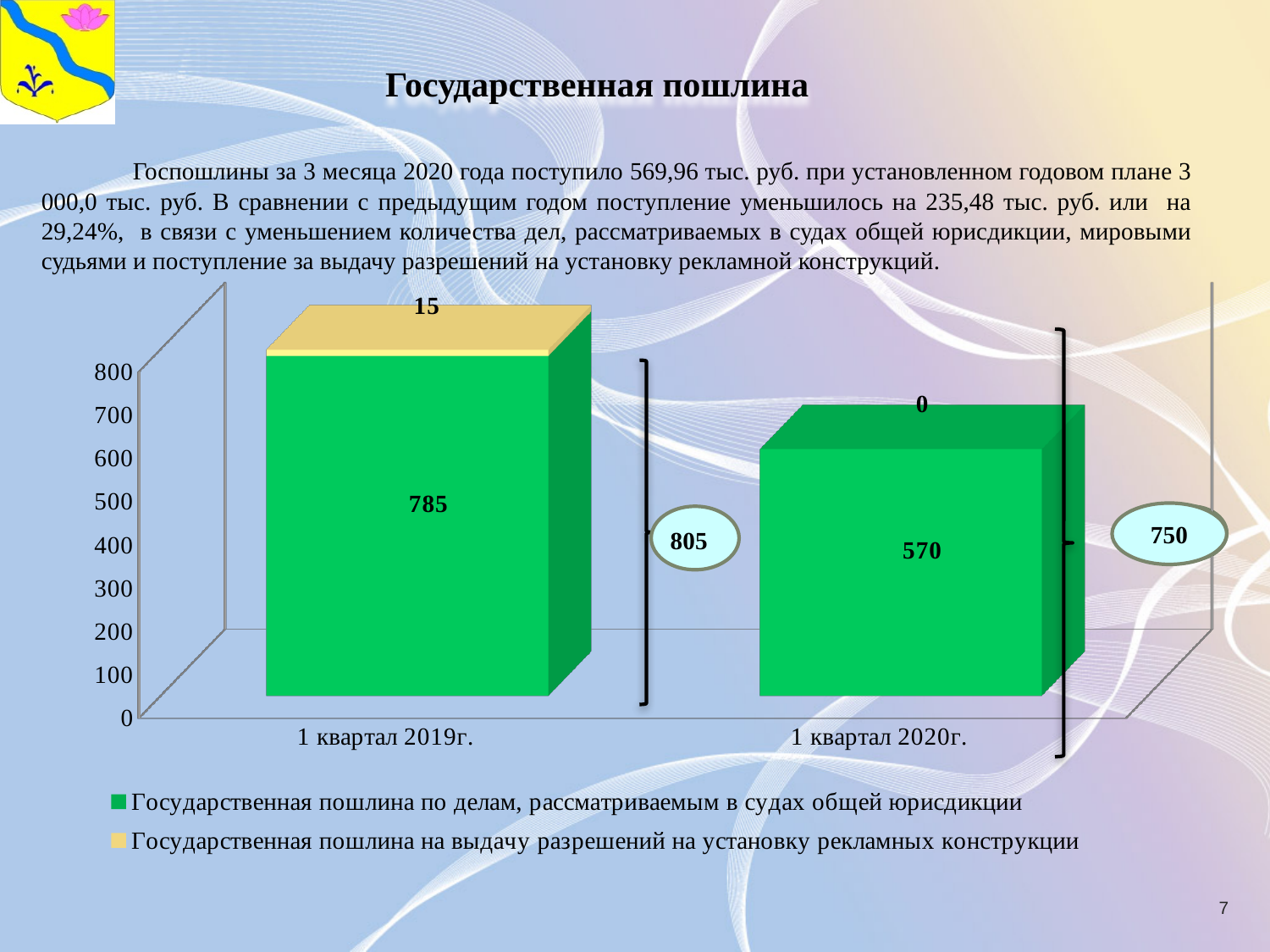
How many series does the chart legend list? 2 What is the value of 'Государственная пошлина по делам, рассматриваемым в судах общей юрисдикции' for 1 квартал 2020г.? 570 Which quarter has the higher value for the green series (court fees)? 1 квартал 2019г. Does the green series value rise or fall from 1 квартал 2019г. to 1 квартал 2020г.? Fall What is the value of 'Государственная пошлина на выдачу разрешений на установку рекламных конструкции' for 1 квартал 2020г.? 0 What kind of chart is shown on the slide? Bar chart What is the difference between the court-fee values (green series) for 1 квартал 2019г. and 1 квартал 2020г.? 215 What is the value of 'Государственная пошлина на выдачу разрешений на установку рекламных конструкции' for 1 квартал 2019г.? 15 What is the value of 'Государственная пошлина по делам, рассматриваемым в судах общей юрисдикции' for 1 квартал 2019г.? 785 What is the total of the stacked bar for 1 квартал 2020г.? 570 How many categories are shown on the x axis of the chart? 2 What is the total of the stacked bar for 1 квартал 2019г.? 800